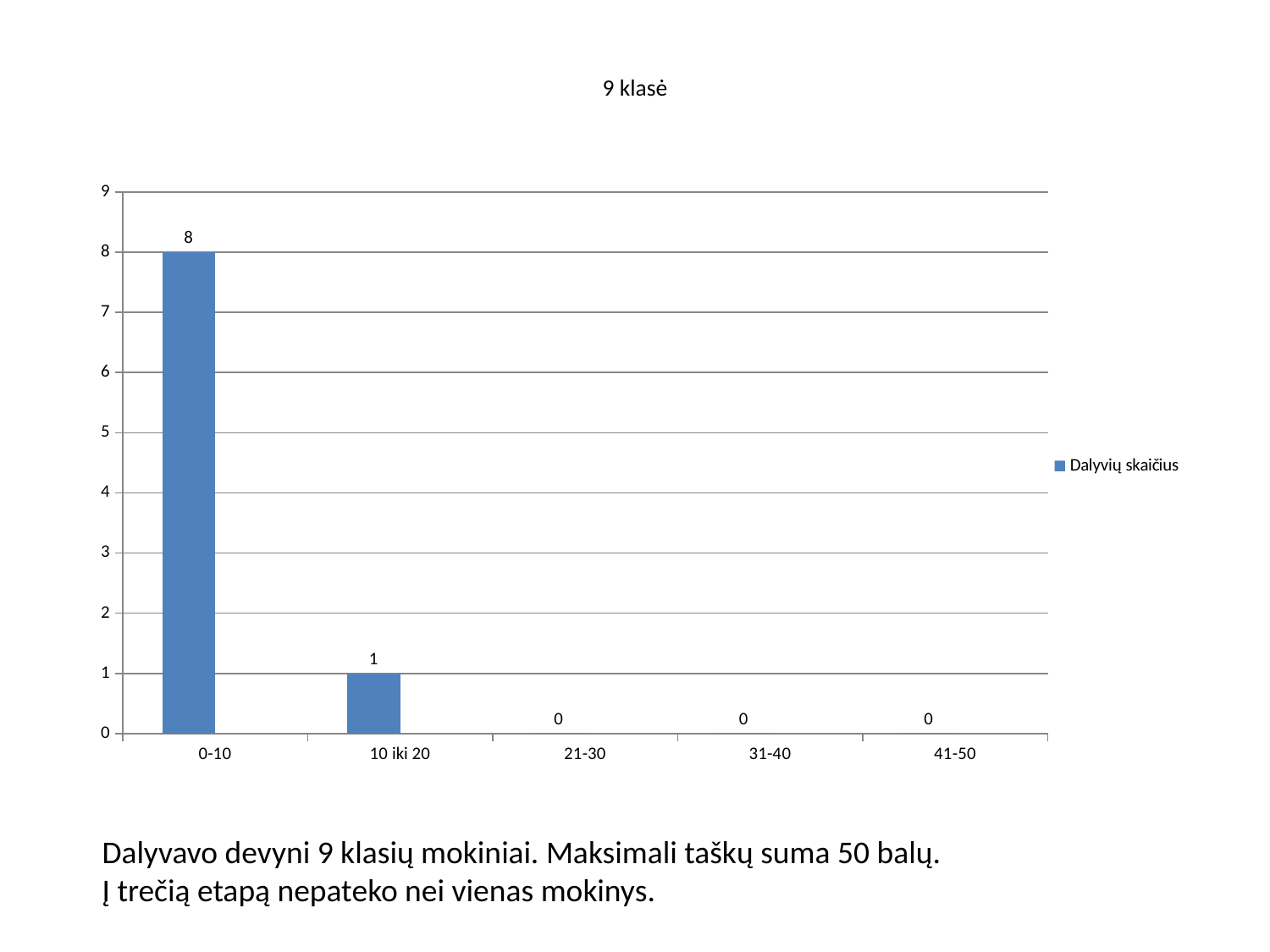
Which is larger, the value for 0-10 or the value for 10 iki 20? 0-10 How many series does the legend list? 1 What is the value for the 0-10 category? 8 What is the difference between the values for 0-10 and 10 iki 20? 7 What is the value for the 41-50 category? 0 What is the title of the chart? 9 klasė What is the name of the series in the legend? Dalyvių skaičius How many categories are shown on the x axis? 5 What is the value for the 10 iki 20 category? 1 Which category has the highest value? 0-10 What kind of chart is shown? bar chart Is the value for 0-10 greater or less than 5? greater